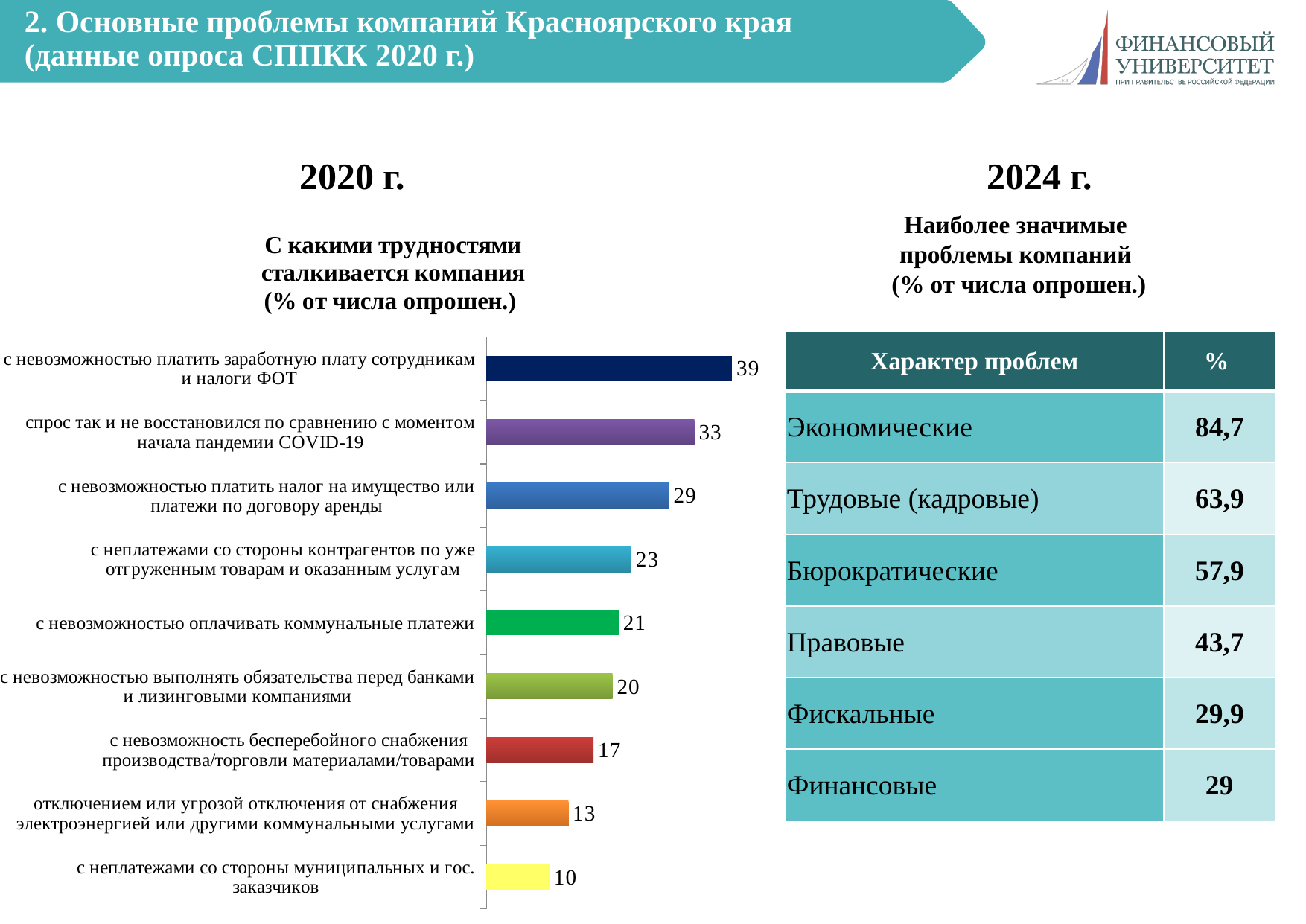
What is the value for 'отключением или угрозой отключения от снабжения электроэнергией или другими коммунальными услугами' in the 2020 bar chart? 13 Which category has the highest value in the 2020 bar chart? с невозможностью платить заработную плату сотрудникам и налоги ФОТ What is the value for 'с неплатежами со стороны контрагентов по уже отгруженным товарам и оказанным услугам' in the 2020 bar chart? 23 In the 2020 bar chart, what is the difference between the value for 'спрос так и не восстановился по сравнению с моментом начала пандемии COVID-19' and the value for 'с невозможностью платить налог на имущество или платежи по договору аренды'? 4 In the 2020 bar chart, which is larger: the value for 'с невозможность бесперебойного снабжения производства/торговли материалами/товарами' or the value for 'с невозможностью выполнять обязательства перед банками и лизинговыми компаниями'? с невозможностью выполнять обязательства перед банками и лизинговыми компаниями What is the value for 'с невозможностью оплачивать коммунальные платежи' in the 2020 bar chart? 21 How many categories are shown in the 2020 bar chart? 9 In the 2020 bar chart, what is the difference between the highest and lowest values? 29 What kind of chart is used for the 2020 data? bar chart Do the bar values in the 2020 chart increase or decrease from top to bottom? decrease What is the value for 'с невозможностью платить заработную плату сотрудникам и налоги ФОТ' in the 2020 bar chart? 39 Which category has the lowest value in the 2020 bar chart? с неплатежами со стороны муниципальных и гос. заказчиков